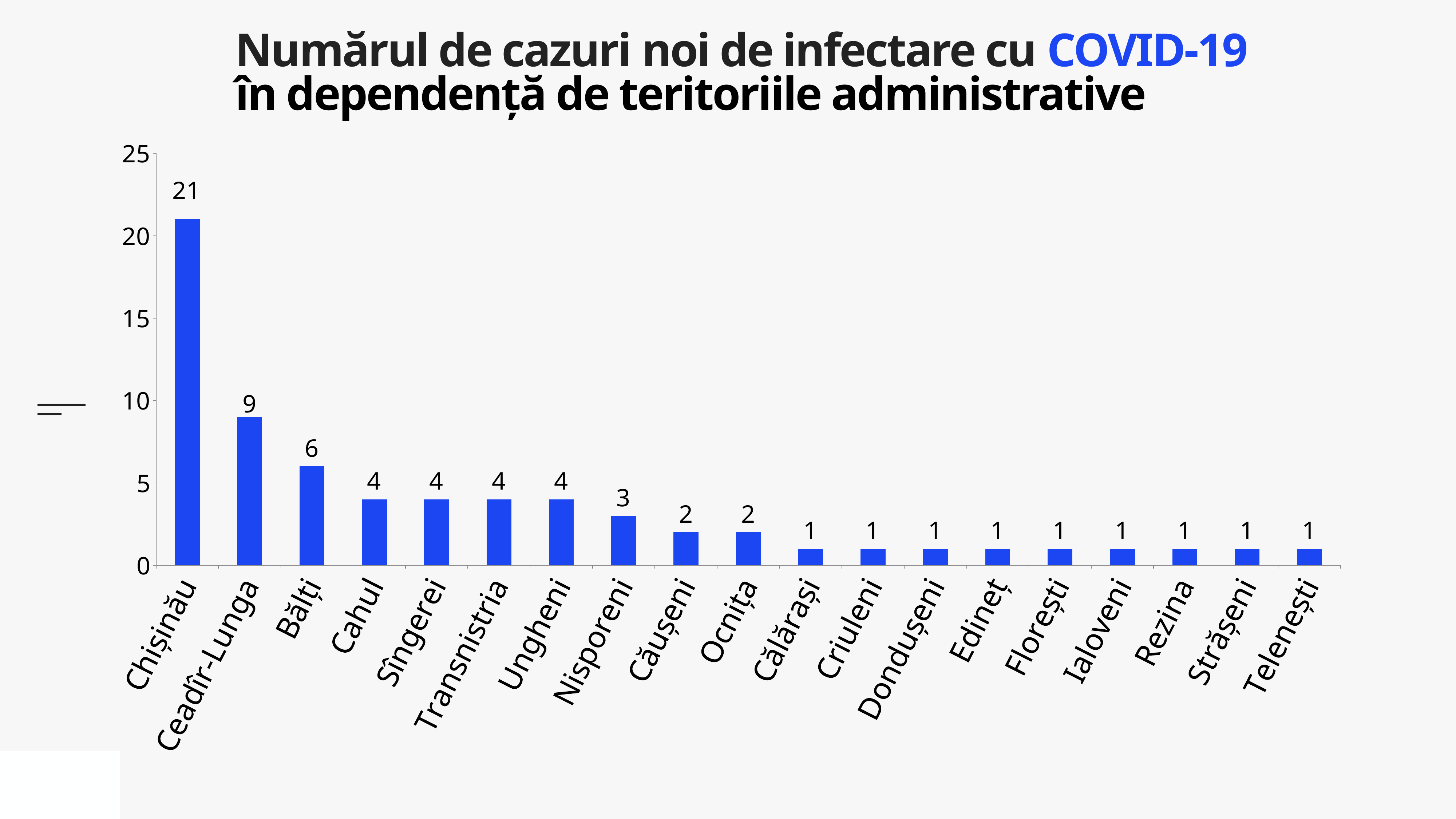
Which is larger, the value for Ceadîr-Lunga or the value for Bălți? Ceadîr-Lunga What kind of chart is shown on the slide? bar chart How many territories are shown on the x axis? 19 What is the value for Chișinău? 21 What is the difference between the values for Chișinău and Ceadîr-Lunga? 12 Which territory has the highest number of new cases? Chișinău What is the value for Ocnița? 2 What is the value for Ceadîr-Lunga? 9 Is the value for Chișinău greater or less than 20? greater What is the value for Nisporeni? 3 What is the value for Bălți? 6 What is the difference between the values for Bălți and Cahul? 2